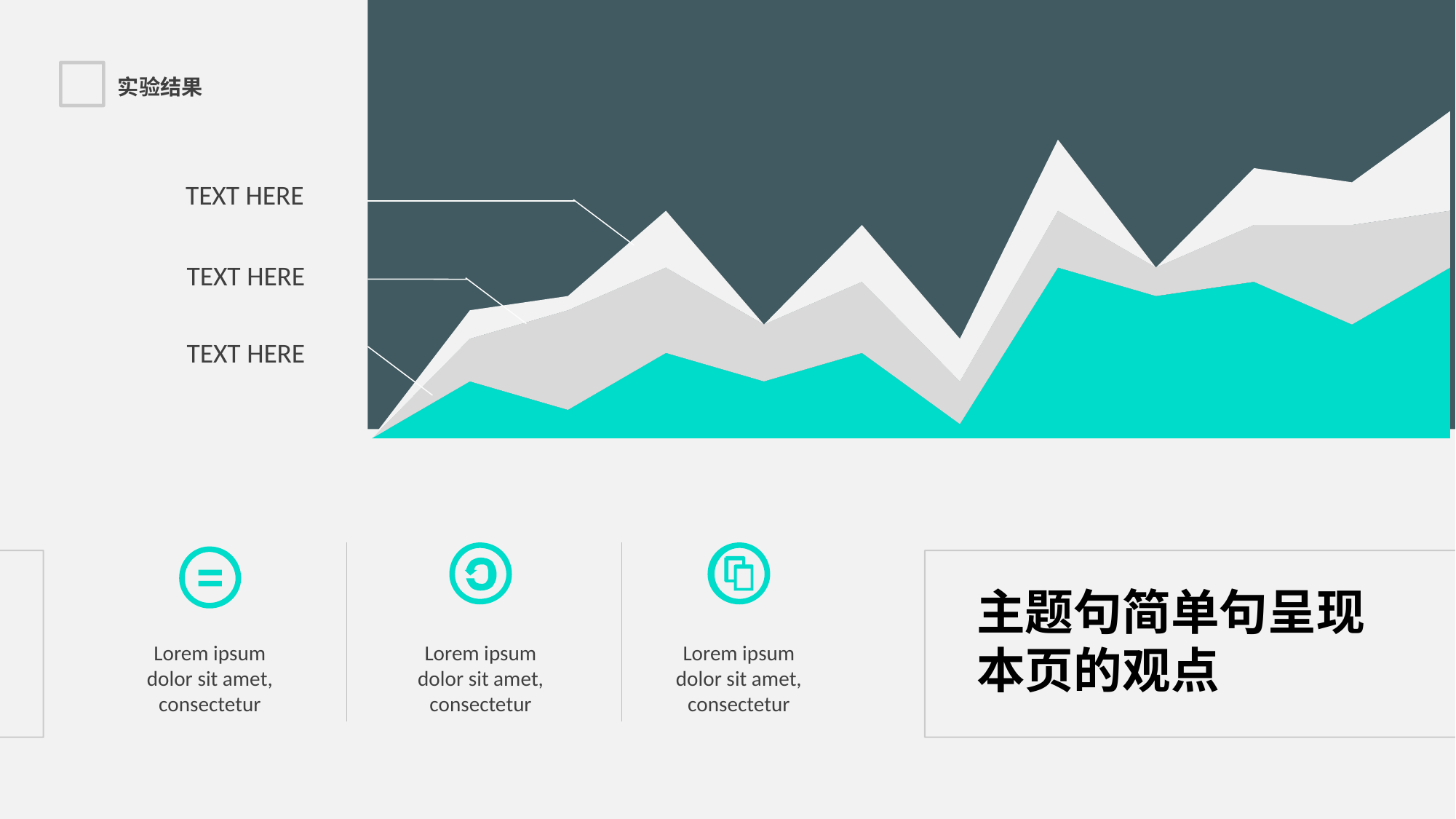
Overall, do the values in the area chart rise or fall from left to right? rise Where does the teal series reach its lowest point? at the far left What colour is the bottom layer of the area chart? teal Does the area chart print any numeric axis values or data labels? No What label text is used for each of the three series in the area chart? TEXT HERE For the teal series, is the value at the far right end higher or lower than at the far left end? higher How many data series (layers) does the area chart show? 3 What kind of chart is shown on the slide? area chart